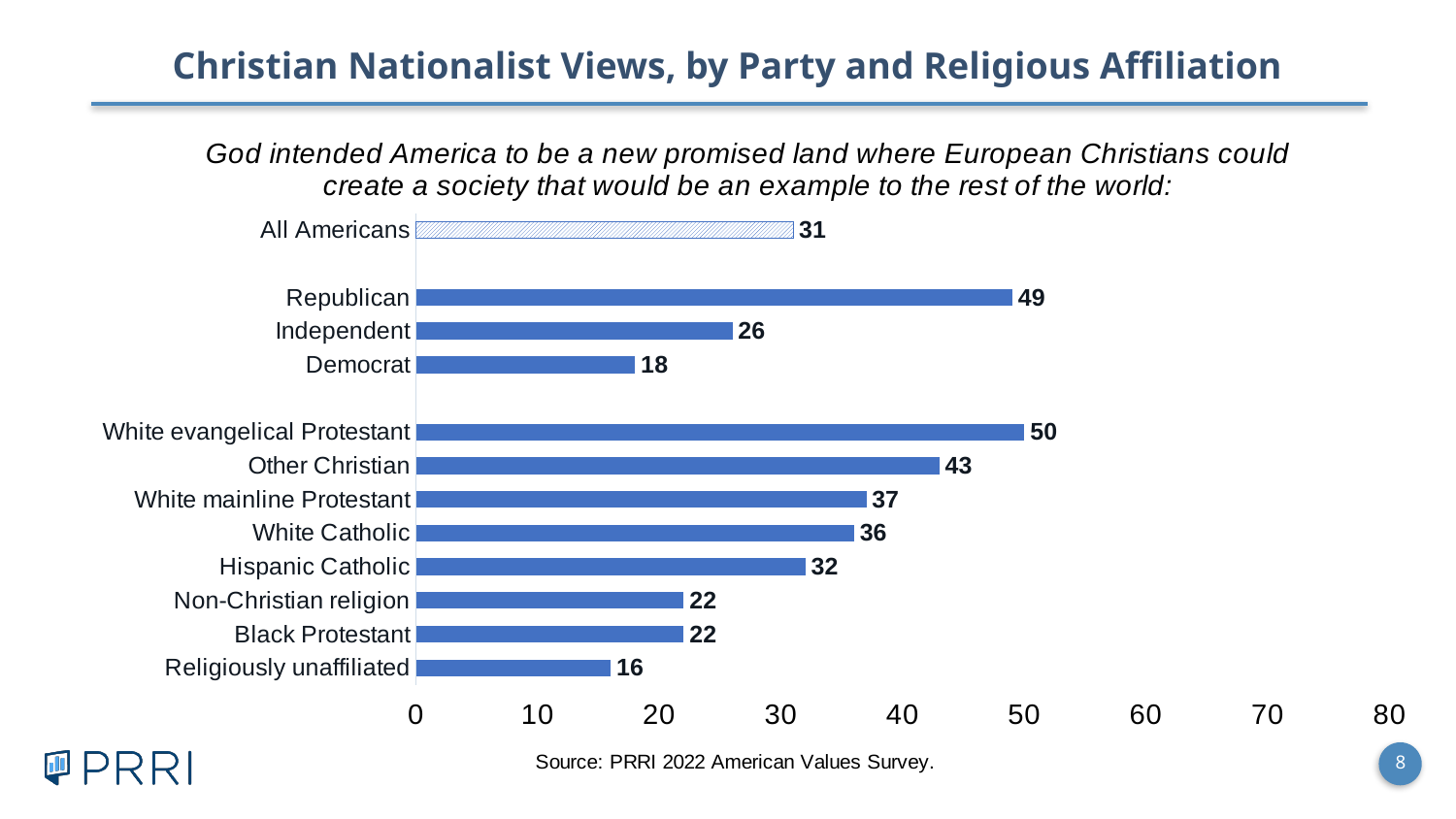
What is the value for Hispanic Catholic? 32 What is the difference between the values for Republican and Democrat? 31 What is the value for Republican? 49 What is the title of the slide? Christian Nationalist Views, by Party and Religious Affiliation What is the value for All Americans? 31 Which is larger, the value for Other Christian or the value for White mainline Protestant? Other Christian What is the difference between the values for White evangelical Protestant and Religiously unaffiliated? 34 How many categories are plotted in the chart? 12 What kind of chart is shown on the slide? bar chart Which category has the lowest value? Religiously unaffiliated Which category has the highest value? White evangelical Protestant Is the value for Independent greater or less than 30? less